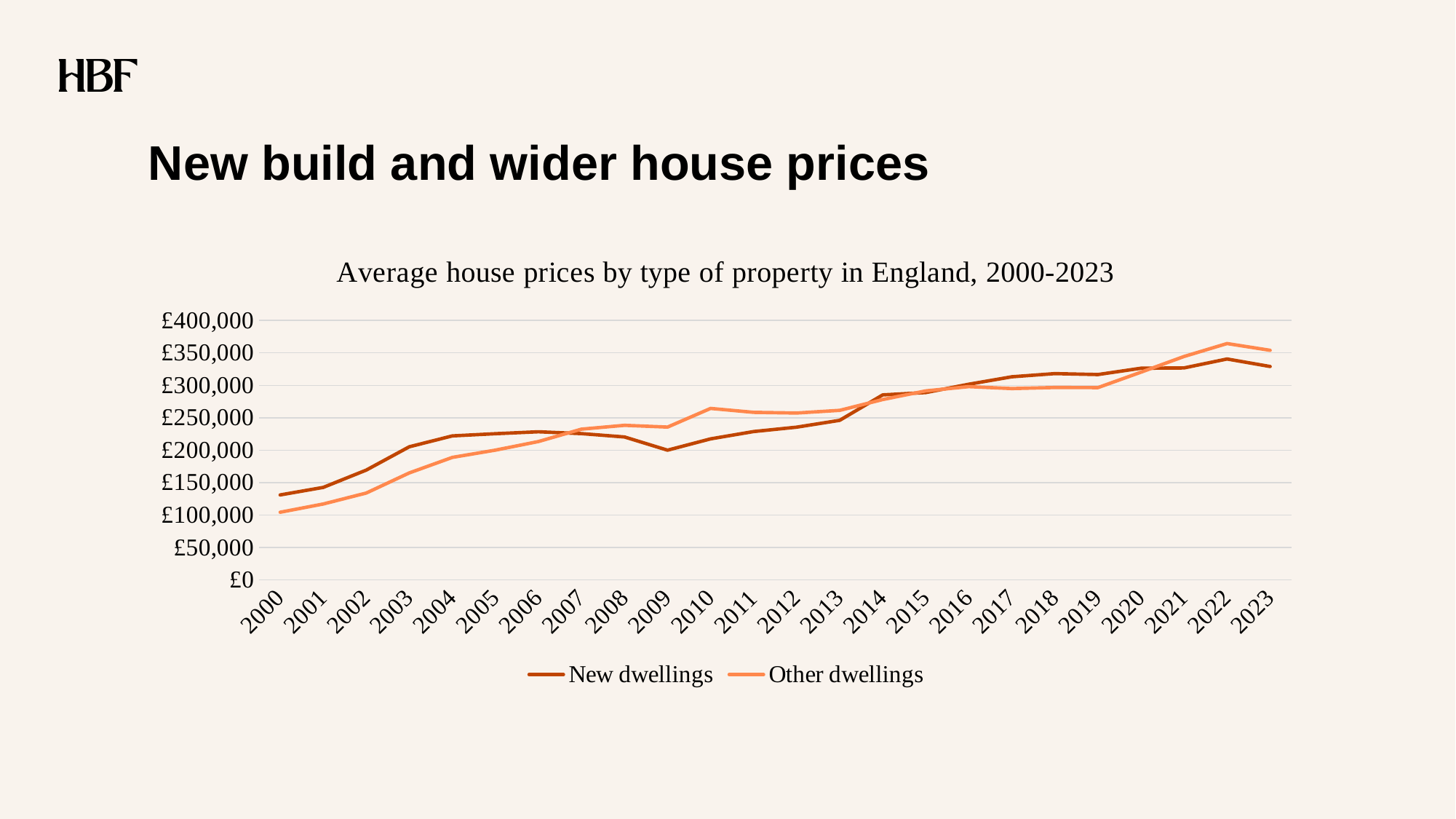
Is the value for New dwellings in 2000 greater or less than £100,000? greater In 2003, which series has the higher value, New dwellings or Other dwellings? New dwellings Is the value for Other dwellings in 2022 greater or less than £350,000? greater Is the value for Other dwellings in 2004 greater or less than £200,000? less What kind of chart is shown on the slide? Line chart In 2022, which series has the higher value, New dwellings or Other dwellings? Other dwellings Overall, do house prices rise or fall from 2000 to 2023? Rise How many years are plotted along the x axis? 24 In which year does the Other dwellings series reach its highest value? 2022 What is the title of the chart? Average house prices by type of property in England, 2000-2023 How many series does the legend list? 2